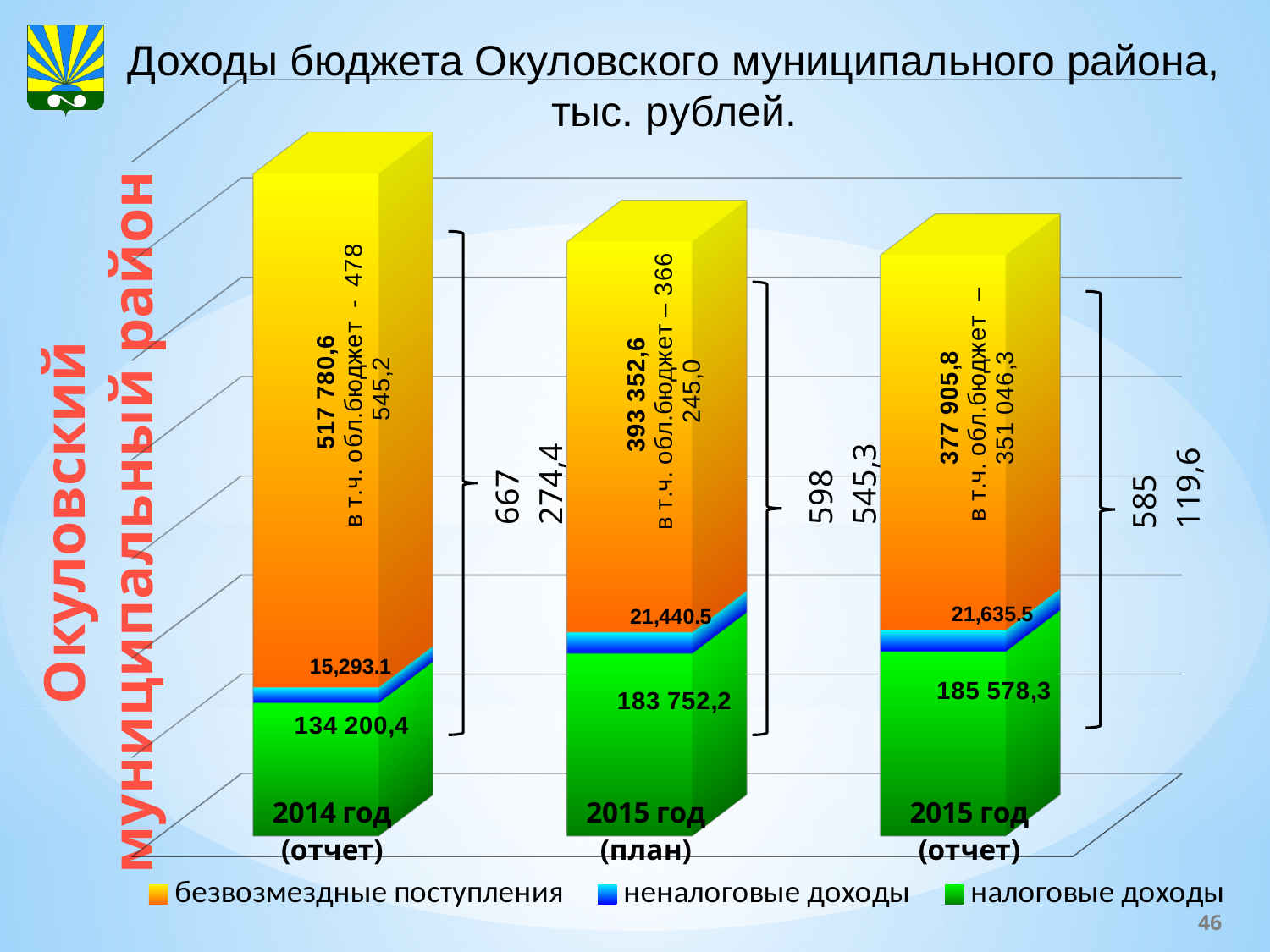
What is the total shown for the 2014 год (отчет) bar? 667 274,4 Which category has the highest value of безвозмездные поступления? 2014 год (отчет) What is the value of налоговые доходы for 2014 год (отчет)? 134 200,4 Which is larger: безвозмездные поступления for 2015 год (план) or for 2015 год (отчет)? 2015 год (план) What type of chart is shown on the slide? stacked bar chart Which category has the lowest value of налоговые доходы? 2014 год (отчет) What is the value of безвозмездные поступления for 2015 год (план)? 393 352,6 What is the value of налоговые доходы for 2015 год (отчет)? 185 578,3 How many series does the legend list? 3 How many categories (bars) are shown on the chart? 3 What is the total shown for the 2015 год (отчет) bar? 585 119,6 What is the value of неналоговые доходы for 2015 год (отчет)? 21,635.5